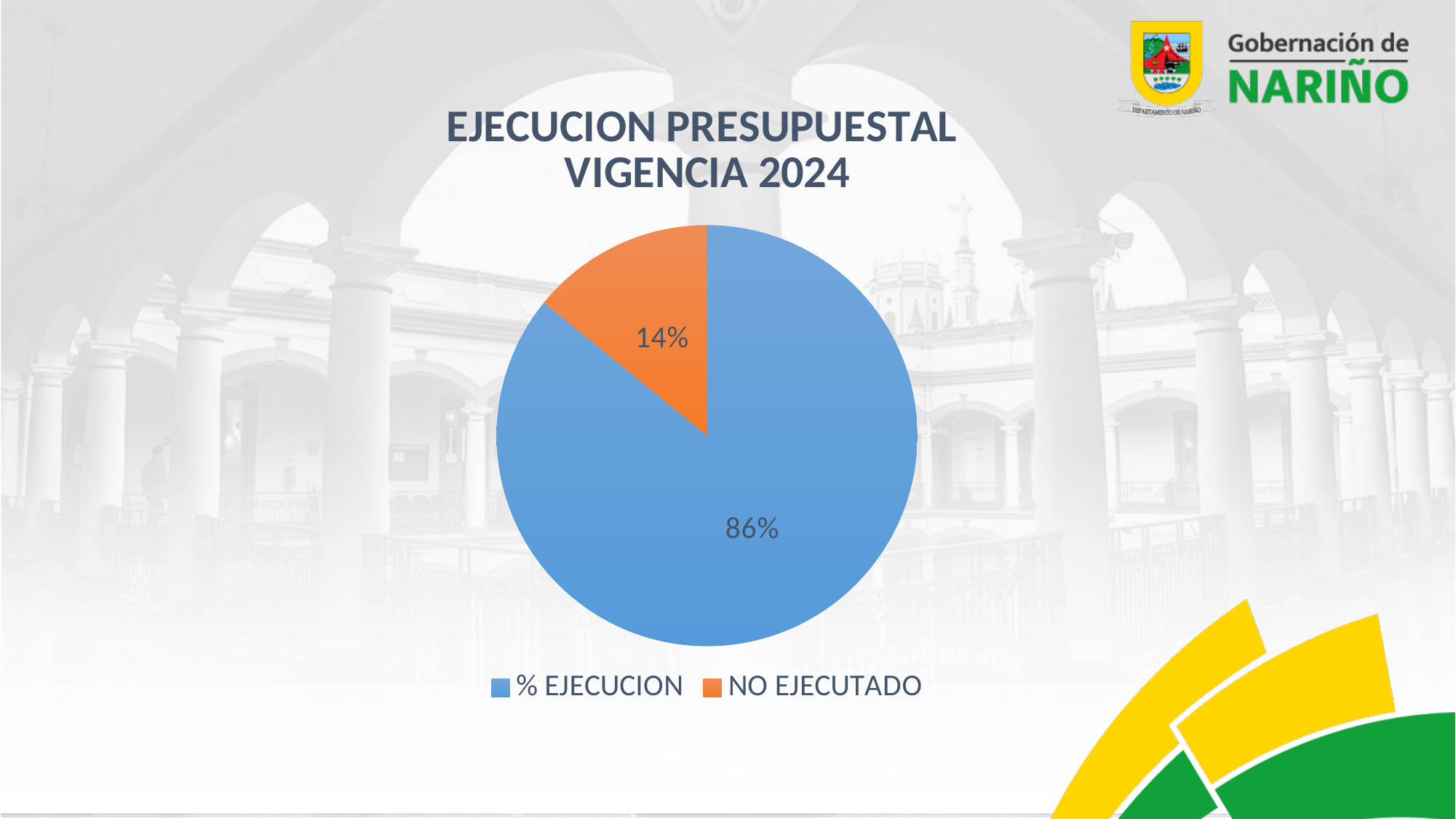
How many entries does the legend list? 2 Which slice of the pie is the largest? % EJECUCION What percentage is shown for % EJECUCION? 86% What share of the pie does the % EJECUCION slice represent? 86% Which is larger, % EJECUCION or NO EJECUTADO? % EJECUCION What colour is the NO EJECUTADO slice? Orange What type of chart is shown on the slide? Pie chart What is the title of the chart? EJECUCION PRESUPUESTAL VIGENCIA 2024 What percentage is shown for NO EJECUTADO? 14% What is the difference in percentage points between % EJECUCION and NO EJECUTADO? 72 How many slices does the pie chart have? 2 Which slice of the pie is the smallest? NO EJECUTADO